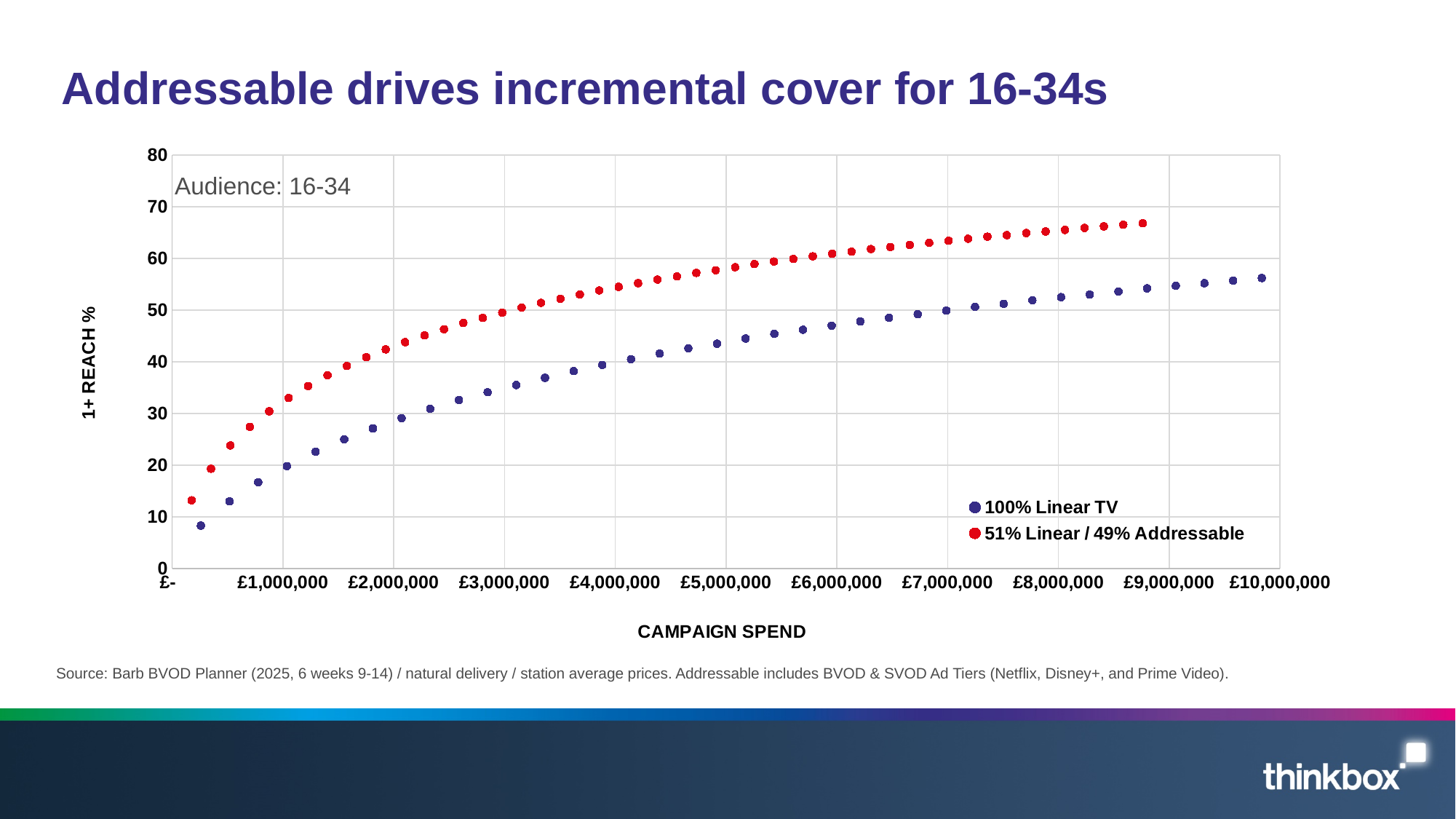
Which series has the lower 1+ reach % across the whole range of campaign spend? 100% Linear TV What is the title of the slide? Addressable drives incremental cover for 16-34s Which series reaches a higher 1+ reach % at a campaign spend of £5,000,000? 51% Linear / 49% Addressable Is the 1+ reach % for 100% Linear TV at a campaign spend of £1,000,000 greater or less than 30? less What is the label of the vertical axis? 1+ REACH % Is the 1+ reach % for 51% Linear / 49% Addressable at a campaign spend of £4,000,000 greater or less than 50? greater Is the 1+ reach % for 100% Linear TV at a campaign spend of £10,000,000 greater or less than 50? greater Do the 1+ reach % values for 100% Linear TV rise or fall as campaign spend increases? rise How many series does the legend list? 2 What kind of chart is shown on the slide? Scatter chart